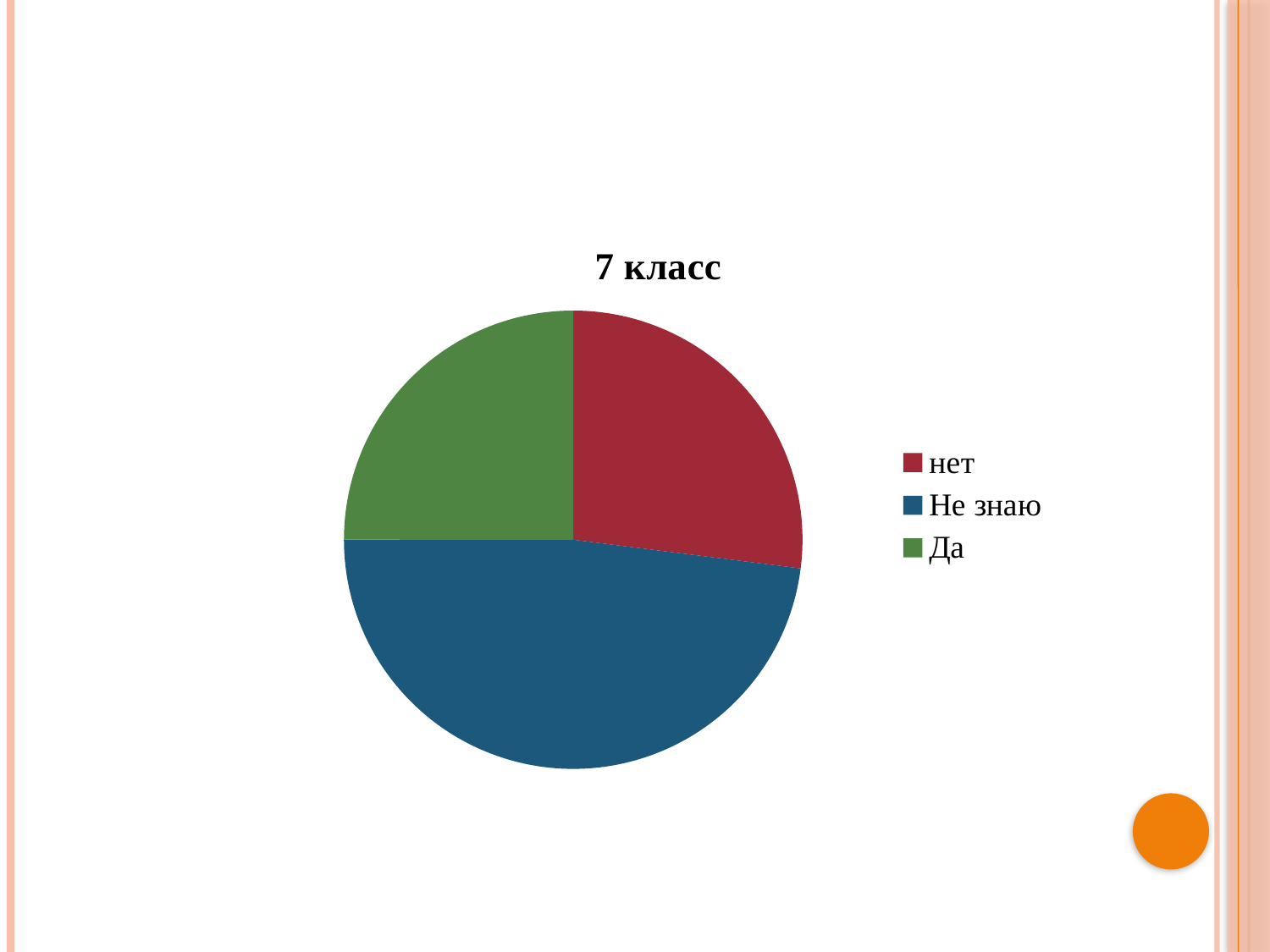
How many slices does the pie chart have? 3 Which category has the largest slice of the pie? Не знаю Which slice is larger, "Не знаю" or "Да"? Не знаю What is the title of the chart? 7 класс Which slice is larger, "Не знаю" or "нет"? Не знаю Which category is shown in green in the legend? Да What kind of chart is shown on the slide? pie chart How many entries does the legend list? 3